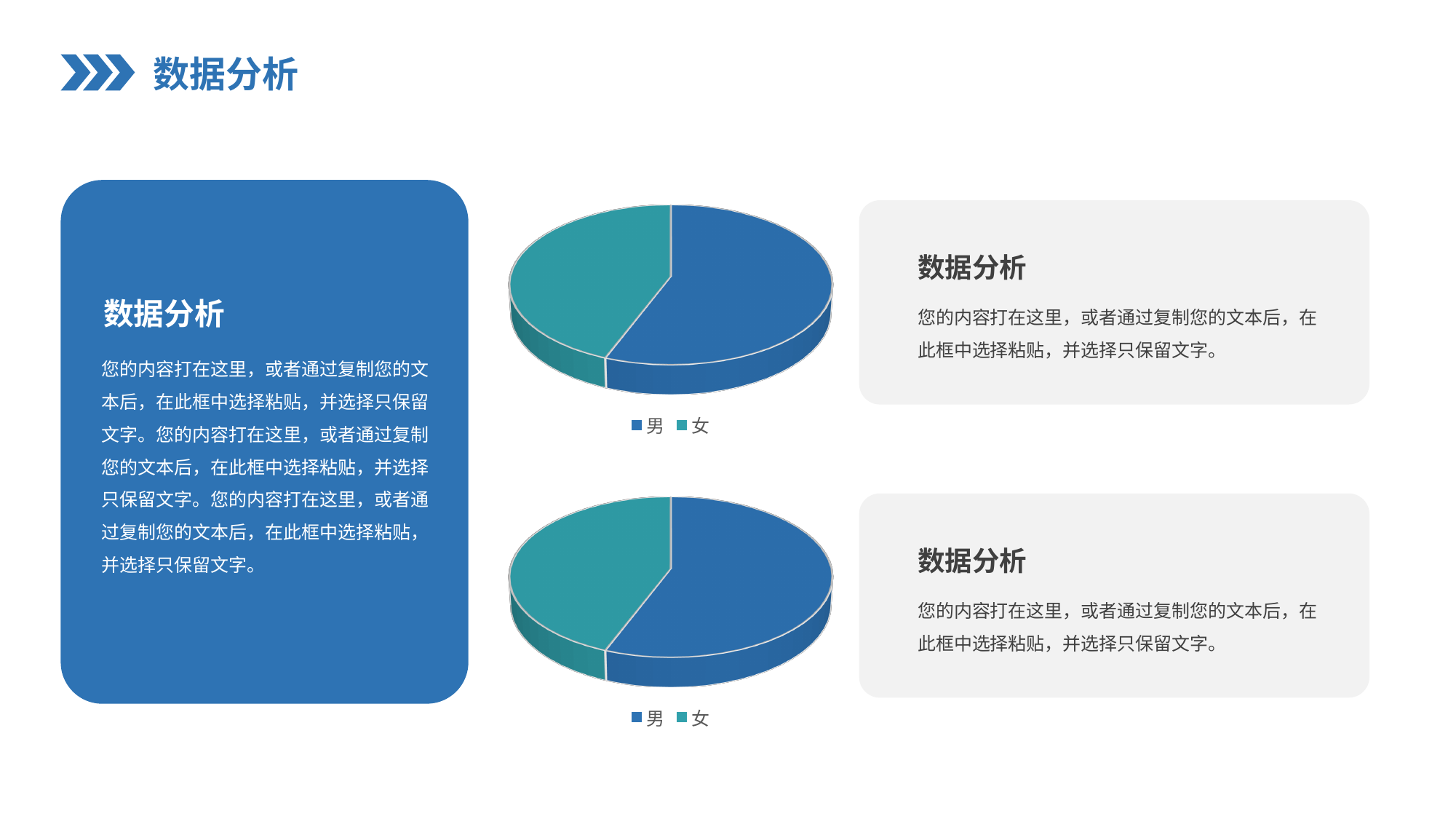
In the top pie chart, how many slices are there? 2 In the bottom pie chart, which slice is larger, 男 or 女? 男 In the bottom pie chart, which category has the smallest slice? 女 In the bottom pie chart, how many slices are there? 2 In the top pie chart, what entries does the legend list? 男, 女 In the top pie chart, which category has the smallest slice? 女 In the bottom pie chart, what colour is the 女 slice? teal In the top pie chart, which category has the largest slice? 男 What kind of chart is the top chart on the slide? pie chart In the top pie chart, which slice is larger, 男 or 女? 男 In the bottom pie chart, which category has the largest slice? 男 What kind of chart is the bottom chart on the slide? pie chart